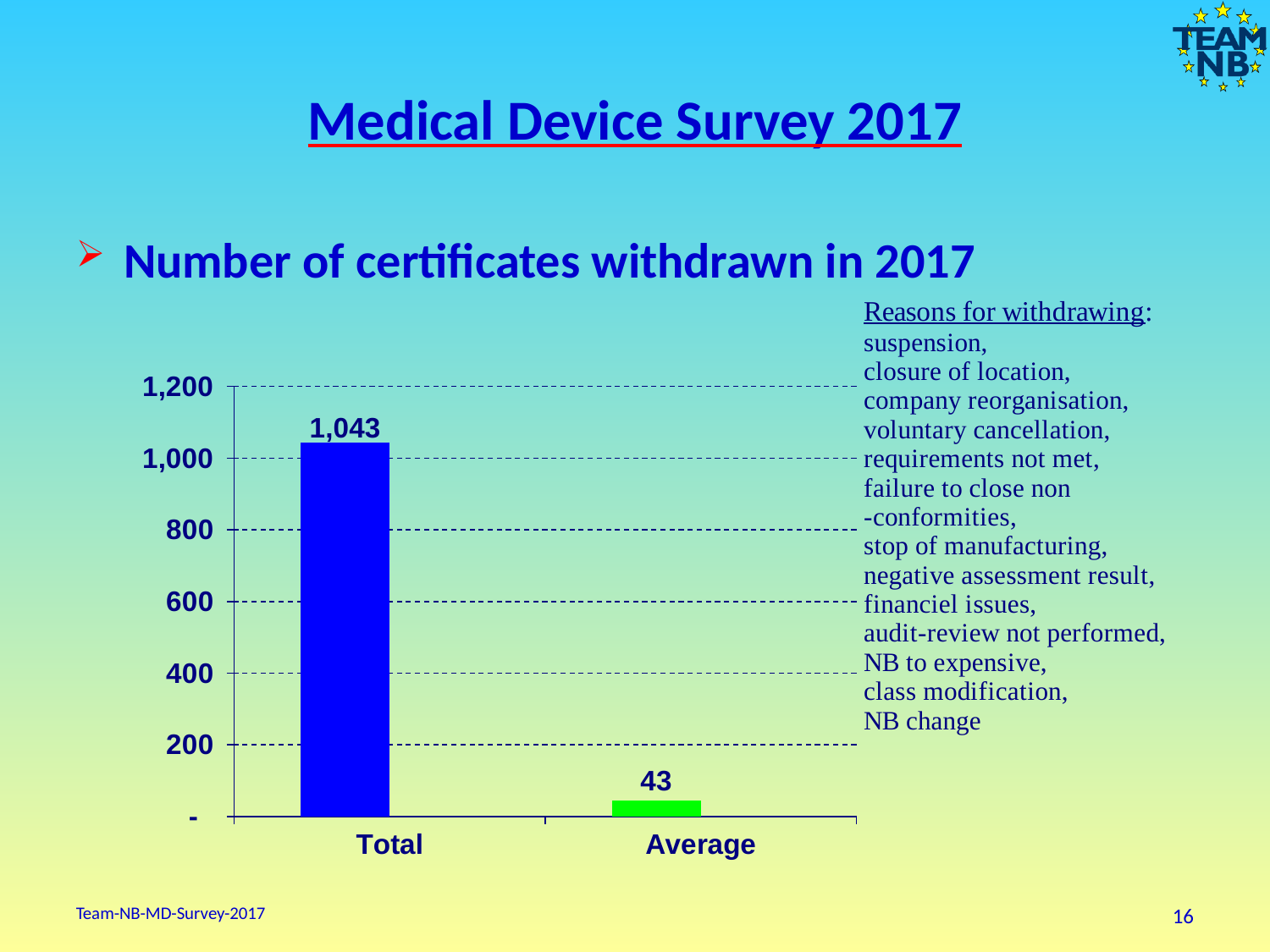
Which is larger, the Total value or the Average value? Total Is the value for Average greater or less than 200? less What is the value of the Average bar? 43 Which category has the lowest value? Average How many categories are shown on the x axis? 2 What kind of chart is shown on the slide? Bar chart What is the difference between the Total and Average values? 1,000 Which category has the highest value? Total Is the value for Total greater or less than 1,000? greater What is the value of the Total bar? 1,043 What is the highest value shown on the y axis? 1,200 What colour is the Average bar? Green